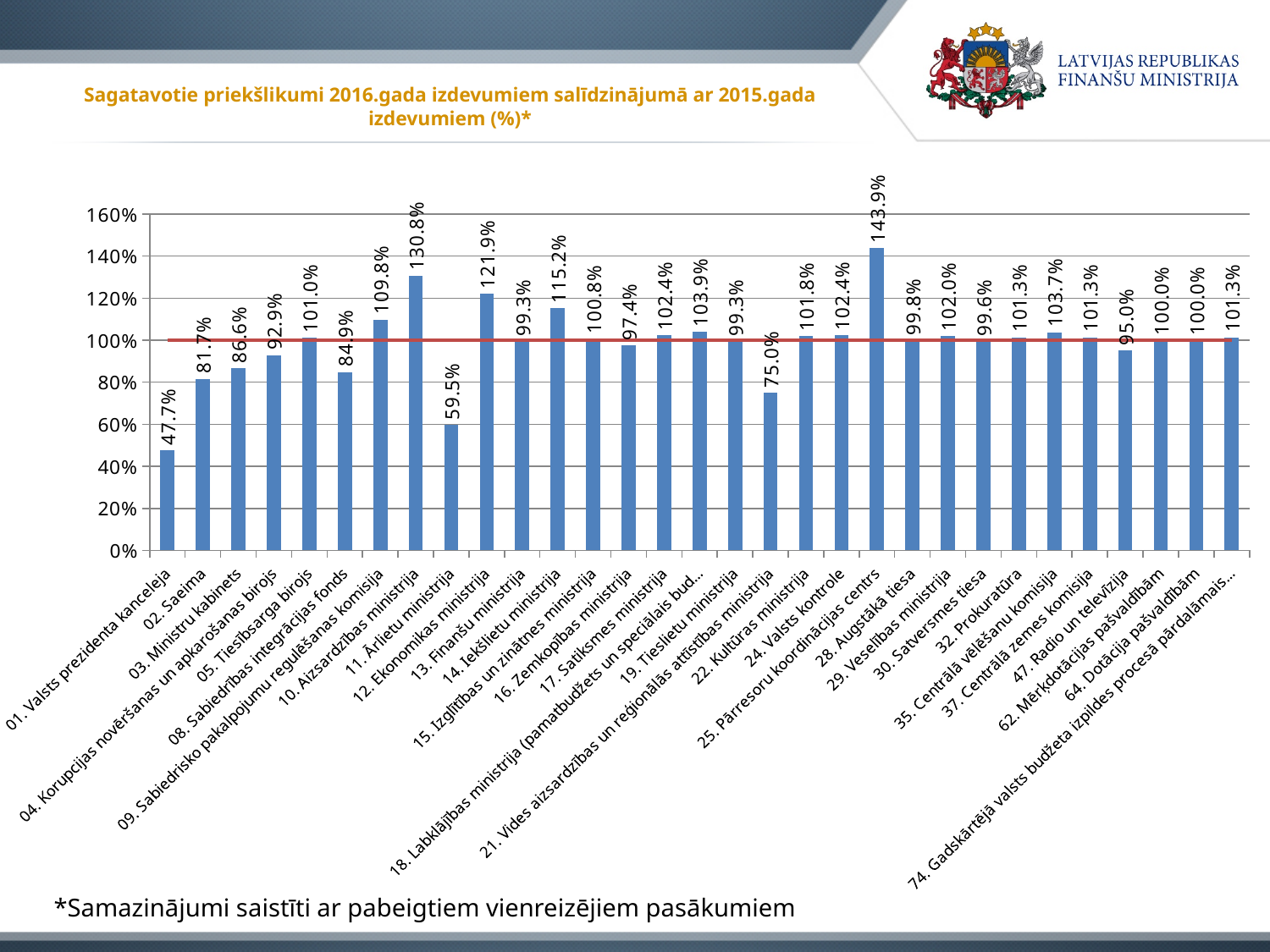
Is the value for 14. Iekšlietu ministrija greater or less than 100%? greater How many categories are shown on the chart? 31 At what level is the horizontal red line drawn on the chart? 100% What is the value for 21. Vides aizsardzības un reģionālās attīstības ministrija? 75.0% What is the value for 47. Radio un televīzija? 95.0% What kind of chart is shown on the slide? Bar chart Which is larger, the value for 11. Ārlietu ministrija or the value for 02. Saeima? 02. Saeima What is the value for 10. Aizsardzības ministrija? 130.8% What is the difference between the values for 10. Aizsardzības ministrija and 12. Ekonomikas ministrija? 8.9 percentage points What is the value for 01. Valsts prezidenta kanceleja? 47.7% Which category has the lowest value? 01. Valsts prezidenta kanceleja Which category has the highest value? 25. Pārresoru koordinācijas centrs